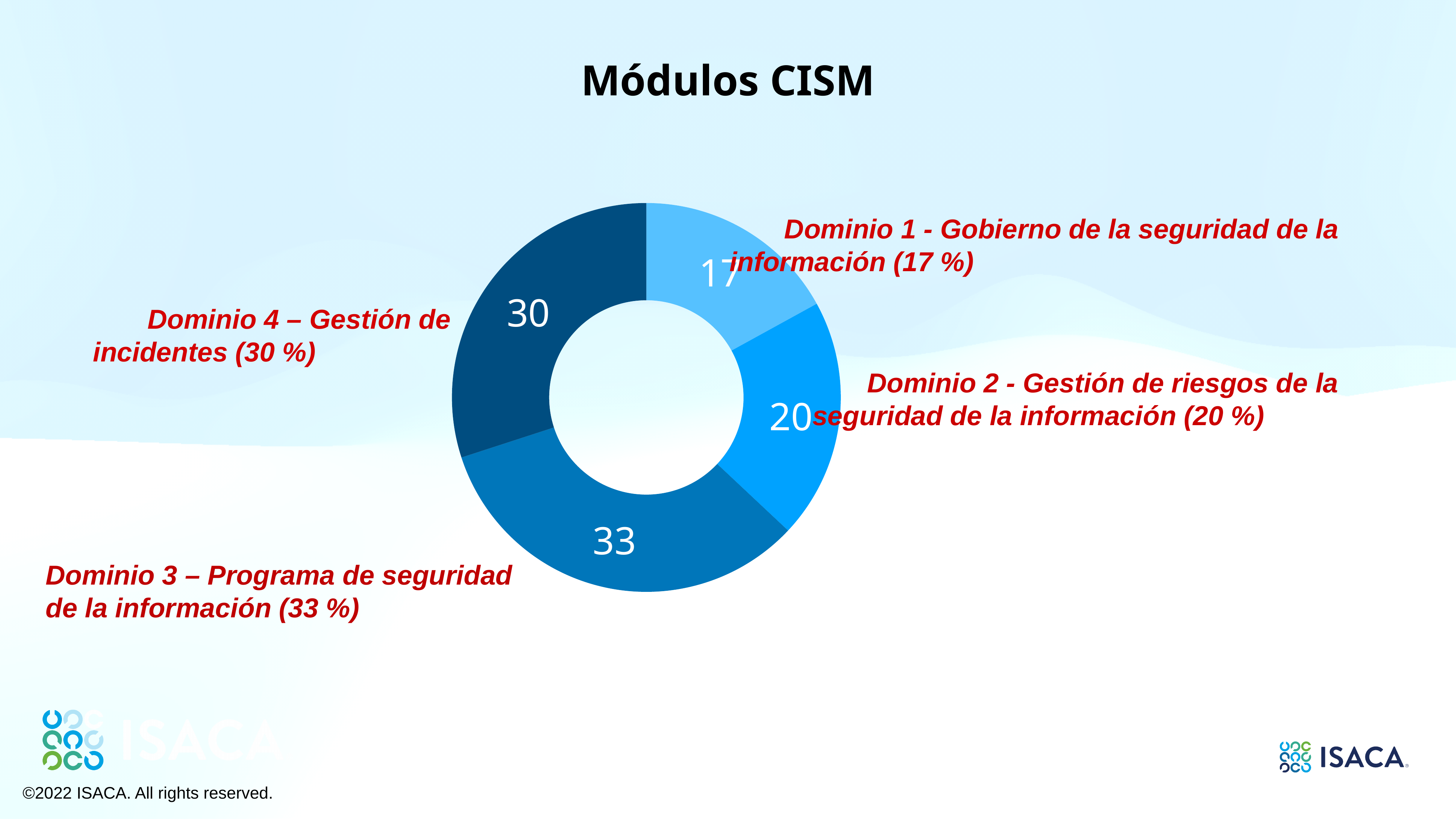
What is the difference between the values for Dominio 3 and Dominio 1? 16 What is the value shown for Dominio 4 – Gestión de incidentes? 30 What kind of chart is shown on the slide? Doughnut (pie) chart Which domain has the smallest share of the chart? Dominio 1 - Gobierno de la seguridad de la información How many domains (slices) does the chart show? 4 Which domain has the largest share of the chart? Dominio 3 – Programa de seguridad de la información What is the value shown for Dominio 2 - Gestión de riesgos de la seguridad de la información? 20 What is the title of the slide containing the chart? Módulos CISM What is the value shown for Dominio 1 - Gobierno de la seguridad de la información? 17 Which is larger, the value for Dominio 4 or the value for Dominio 2? Dominio 4 What percentage share does Dominio 2 represent according to its label? 20 % What is the value shown for Dominio 3 – Programa de seguridad de la información? 33